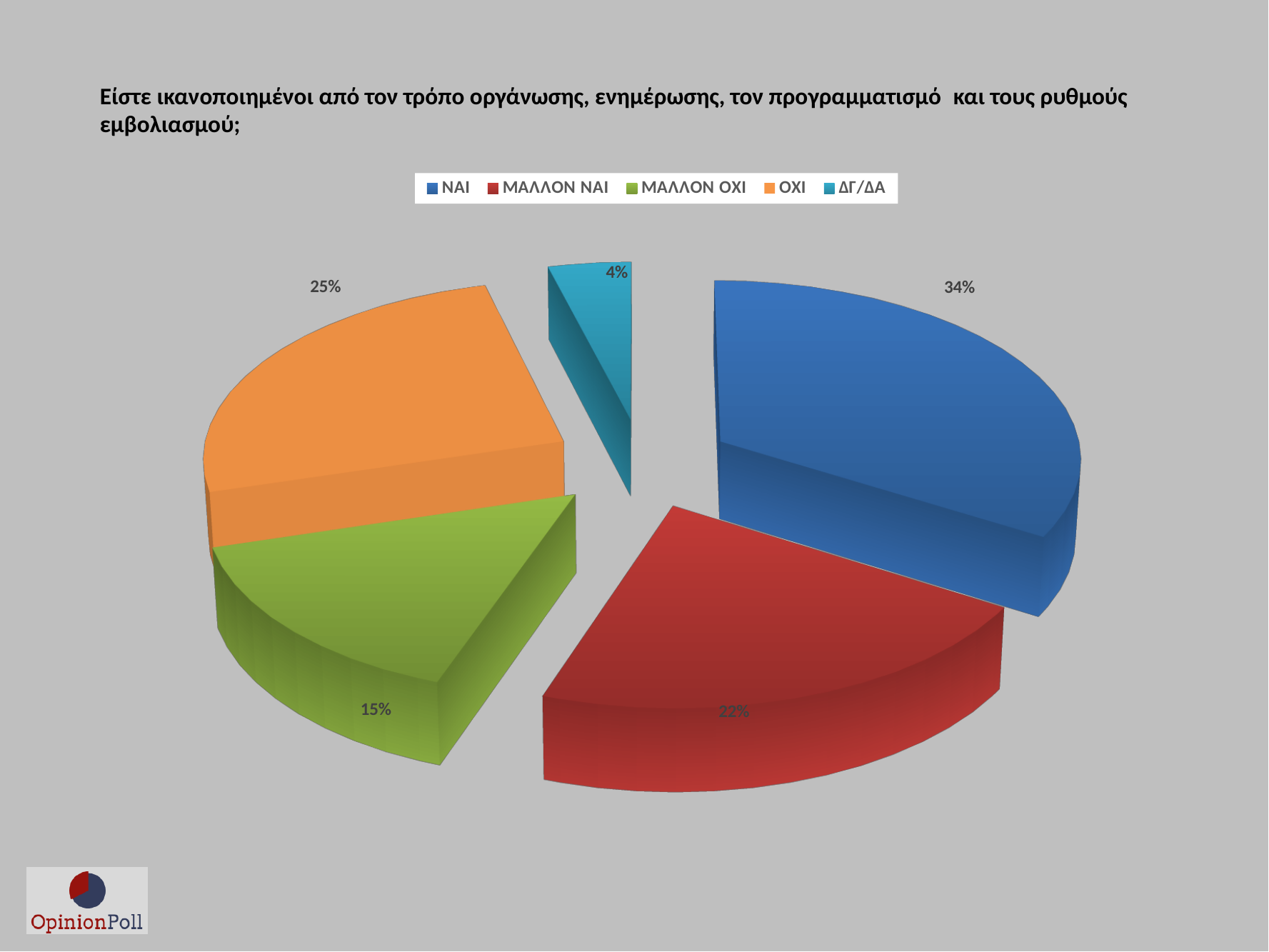
Which response has the smallest share of the pie? ΔΓ/ΔΑ What percentage of respondents answered ΔΓ/ΔΑ? 4% Which is larger, the share for ΜΑΛΛΟΝ ΝΑΙ or the share for ΜΑΛΛΟΝ ΟΧΙ? ΜΑΛΛΟΝ ΝΑΙ What percentage of respondents answered ΝΑΙ? 34% Which response has the largest share of the pie? ΝΑΙ What percentage of respondents answered ΜΑΛΛΟΝ ΟΧΙ? 15% What kind of chart is shown on the slide? Pie chart What colour is the slice for ΟΧΙ? Orange How many categories does the legend list? 5 What is the difference in percentage points between ΝΑΙ and ΟΧΙ? 9 What percentage of respondents answered ΟΧΙ? 25% What percentage of respondents answered ΜΑΛΛΟΝ ΝΑΙ? 22%